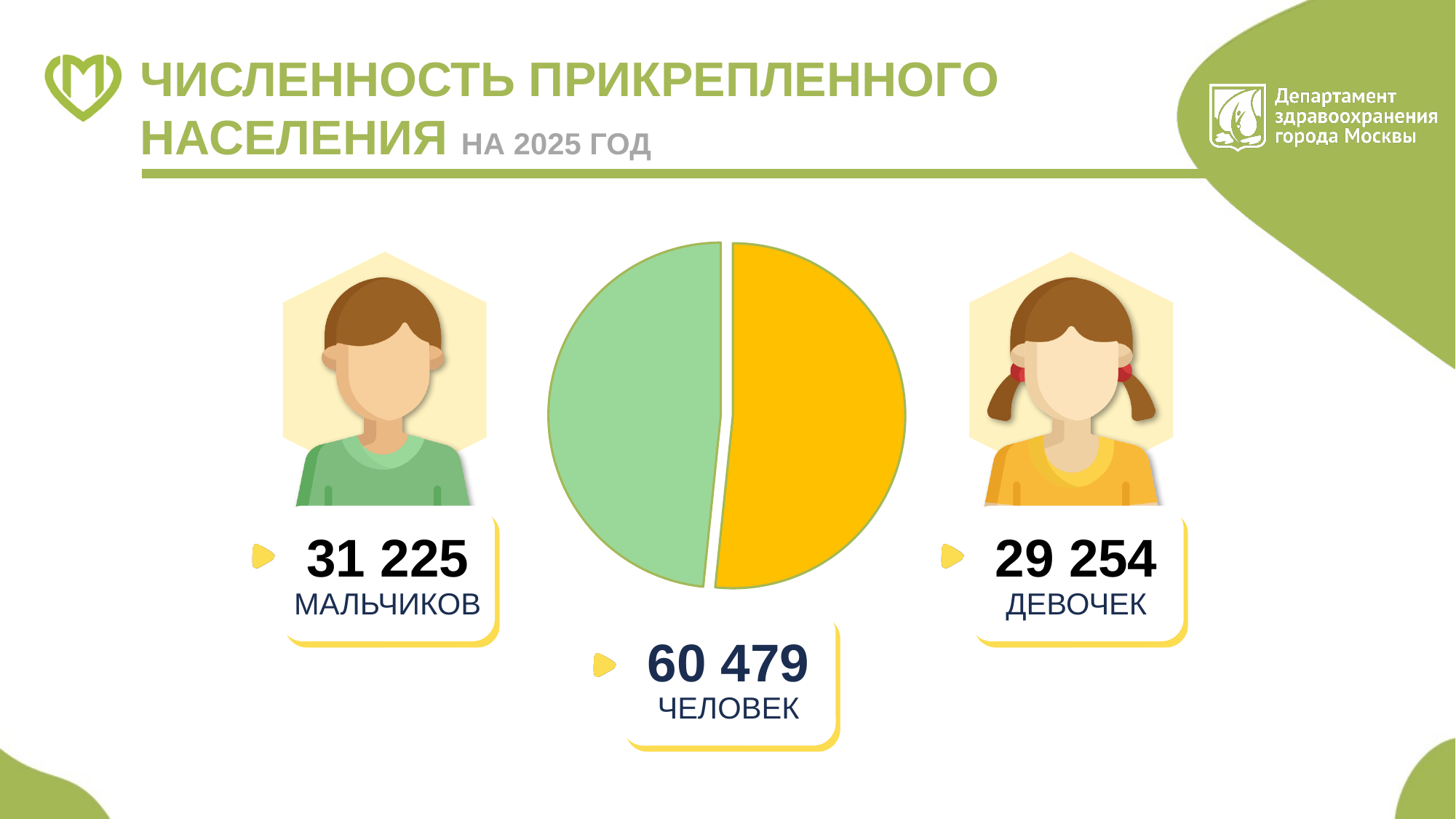
How many slices does the pie chart have? 2 What is the number of boys (мальчиков) shown on the slide? 31 225 What is the total number of people (человек) shown on the slide? 60 479 Which group is smaller in the pie chart, boys or girls? girls Is the number of boys greater or less than the number of girls? greater What kind of chart is shown on the slide? pie chart What is the difference between the number of boys and the number of girls? 1 971 Which group is larger in the pie chart, boys or girls? boys What is the number of girls (девочек) shown on the slide? 29 254 For which year does the slide give the attached population figures? 2025